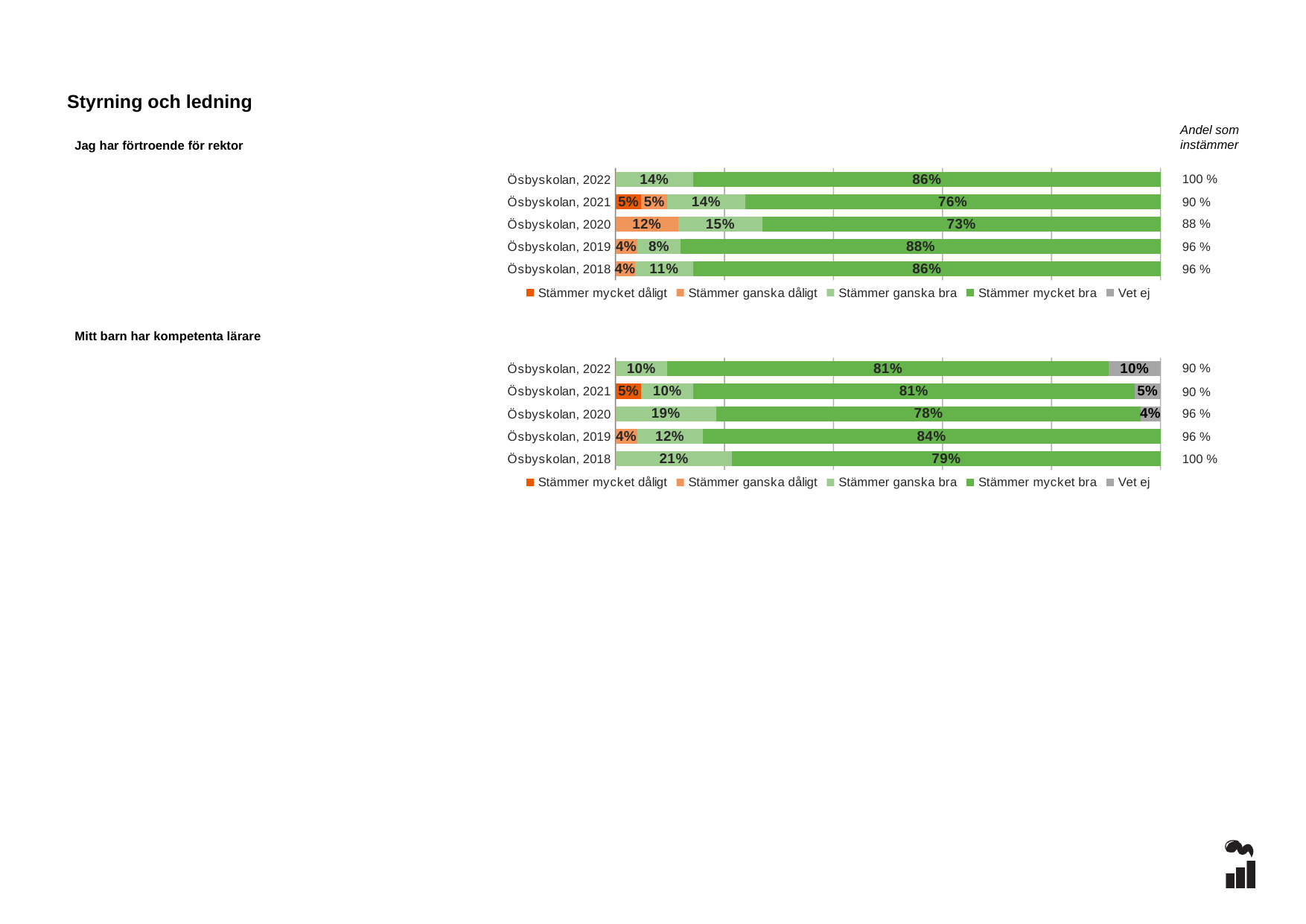
How many bars (years) are shown in the chart 'Jag har förtroende för rektor'? 5 In the chart 'Jag har förtroende för rektor', what is the 'Andel som instämmer' for Ösbyskolan, 2021? 90 % In the chart 'Mitt barn har kompetenta lärare', what is the 'Vet ej' value for Ösbyskolan, 2022? 10% How many series does the legend of the chart 'Mitt barn har kompetenta lärare' list? 5 In the chart 'Jag har förtroende för rektor', what is the 'Stämmer mycket bra' value for Ösbyskolan, 2022? 86% What kind of chart is 'Mitt barn har kompetenta lärare'? Stacked bar chart In the chart 'Jag har förtroende för rektor', what is the 'Stämmer ganska dåligt' value for Ösbyskolan, 2020? 12% In the chart 'Jag har förtroende för rektor', what is the difference between the 'Stämmer mycket bra' values for Ösbyskolan, 2019 and Ösbyskolan, 2020? 15% In the chart 'Mitt barn har kompetenta lärare', what is the 'Stämmer ganska bra' value for Ösbyskolan, 2018? 21% In the chart 'Jag har förtroende för rektor', which year has the highest 'Stämmer mycket bra' value? Ösbyskolan, 2019 In the chart 'Mitt barn har kompetenta lärare', which is larger: the 'Stämmer mycket bra' value for Ösbyskolan, 2019 or for Ösbyskolan, 2020? Ösbyskolan, 2019 In the chart 'Jag har förtroende för rektor', which year has the lowest 'Stämmer mycket bra' value? Ösbyskolan, 2020